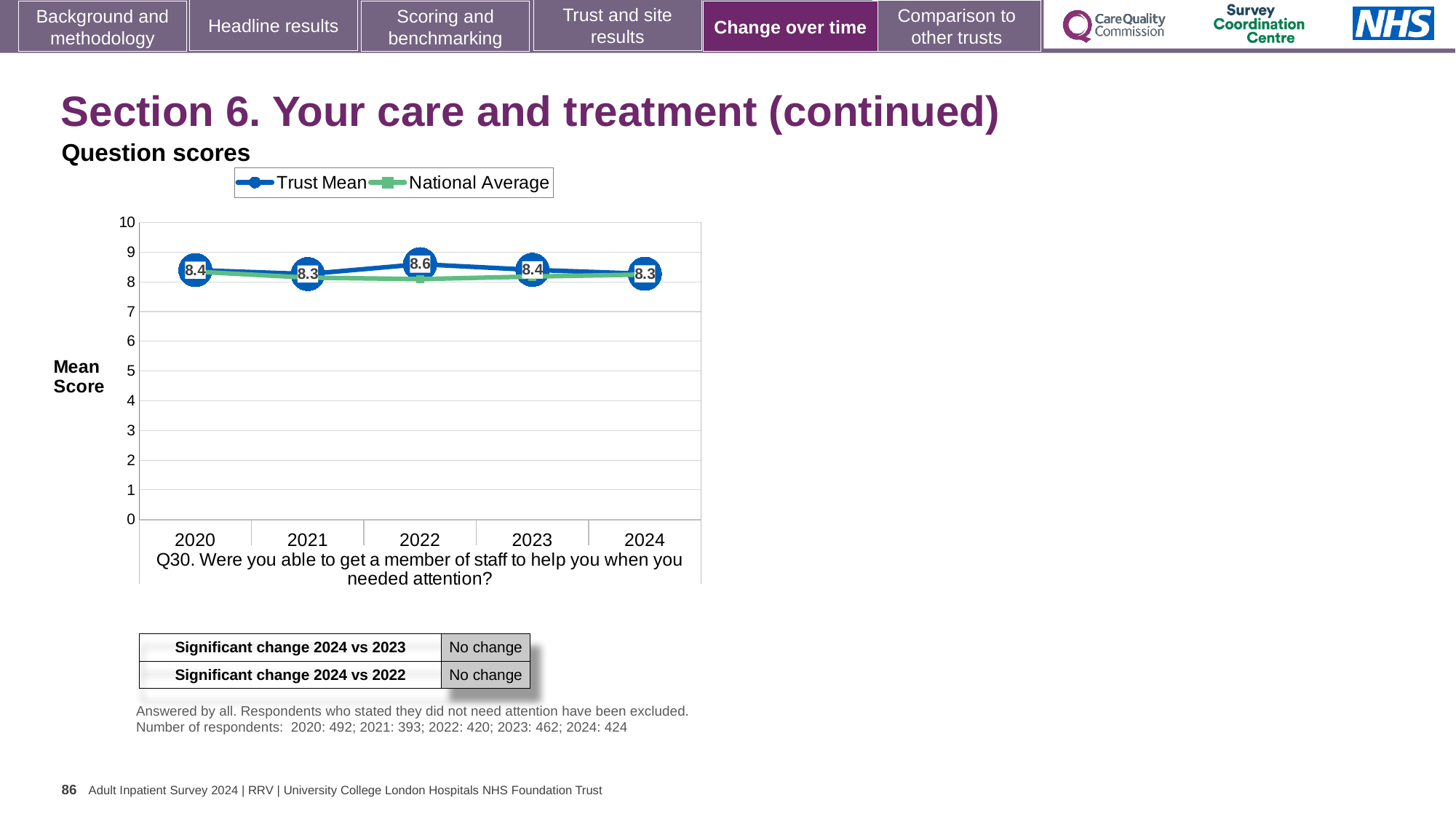
Is the Trust Mean score for 2023 greater or less than 8? greater How many series does the legend list? 2 What is the Trust Mean score for 2020? 8.4 In which year is the Trust Mean score highest? 2022 What is the difference between the Trust Mean score in 2022 and in 2021? 0.3 Which question does the chart show scores for? Q30. Were you able to get a member of staff to help you when you needed attention? How many years are plotted on the x axis? 5 What is the Trust Mean score for 2022? 8.6 Did the Trust Mean score rise or fall from 2022 to 2024? Fall What is the Trust Mean score for 2024? 8.3 What type of chart is shown on the slide? Line chart Is the National Average for 2022 greater or less than 9? less